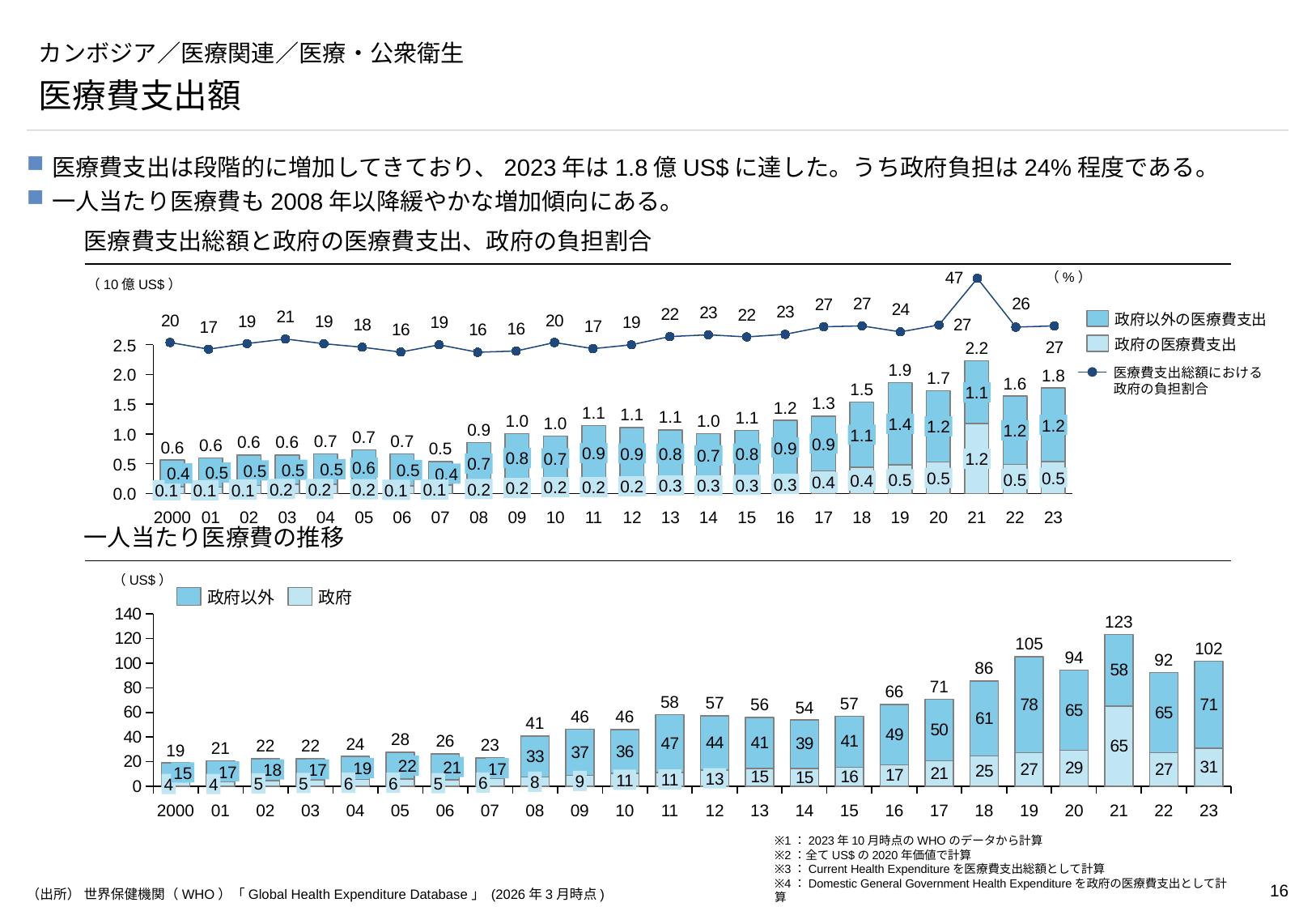
What kind of chart is the bottom chart (一人当たり医療費の推移)? Stacked bar chart In the top chart, which year has the lowest total health expenditure? 2007 How many series does the legend of the top chart list? 3 In the bottom chart (一人当たり医療費の推移), which year has the highest per-capita health expenditure? 2021 In the bottom chart, which year has the larger total per-capita expenditure, 2019 or 2020? 2019 In the top chart (医療費支出総額と政府の医療費支出、政府の負担割合), what is the total health expenditure for 2023? 1.8 In the bottom chart, what is the 政府 value for 2023? 31 How many years are plotted on the x axis of the top chart? 24 In the top chart, what is the government share (%) shown for 2021? 47 In the top chart, in which year does the government share line (政府の負担割合) reach its highest value? 2021 In the bottom chart, what is the difference between the total per-capita expenditure in 2021 and in 2023? 21 In the top chart, what is the value of 政府の医療費支出 for 2021? 1.2